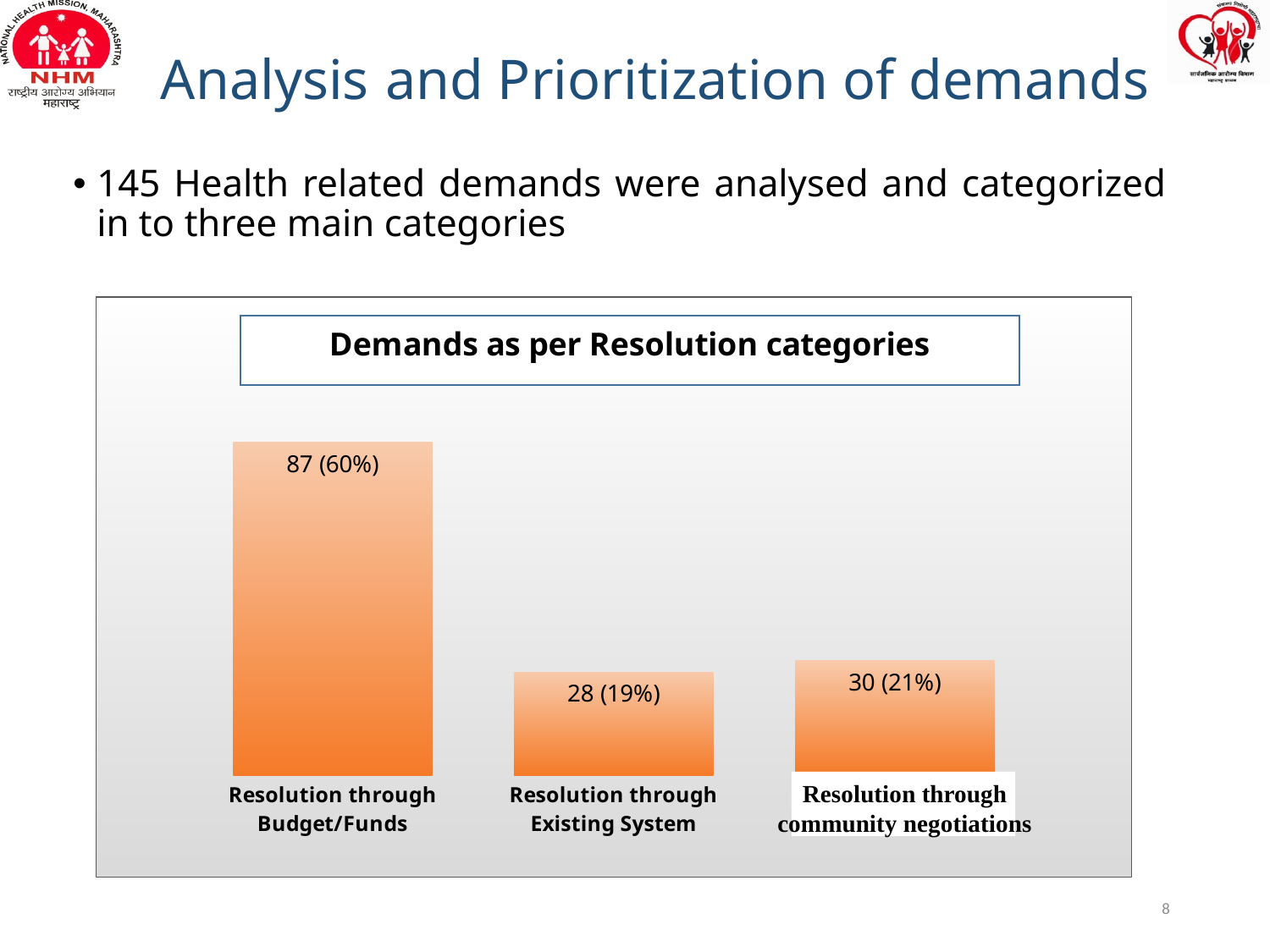
Which category has the highest number of demands? Resolution through Budget/Funds What is the title of the chart? Demands as per Resolution categories What is the value for Resolution through community negotiations? 30 (21%) What is the difference in demands between Resolution through Budget/Funds and Resolution through Existing System? 59 What is the value for Resolution through Existing System? 28 (19%) What is the total number of demands across all three categories? 145 What is the value for Resolution through Budget/Funds? 87 (60%) How many categories are shown in the chart? 3 What is the difference in demands between Resolution through community negotiations and Resolution through Existing System? 2 What kind of chart is shown on the slide? Bar chart Which is larger: Resolution through Budget/Funds or Resolution through community negotiations? Resolution through Budget/Funds Which category has the lowest number of demands? Resolution through Existing System